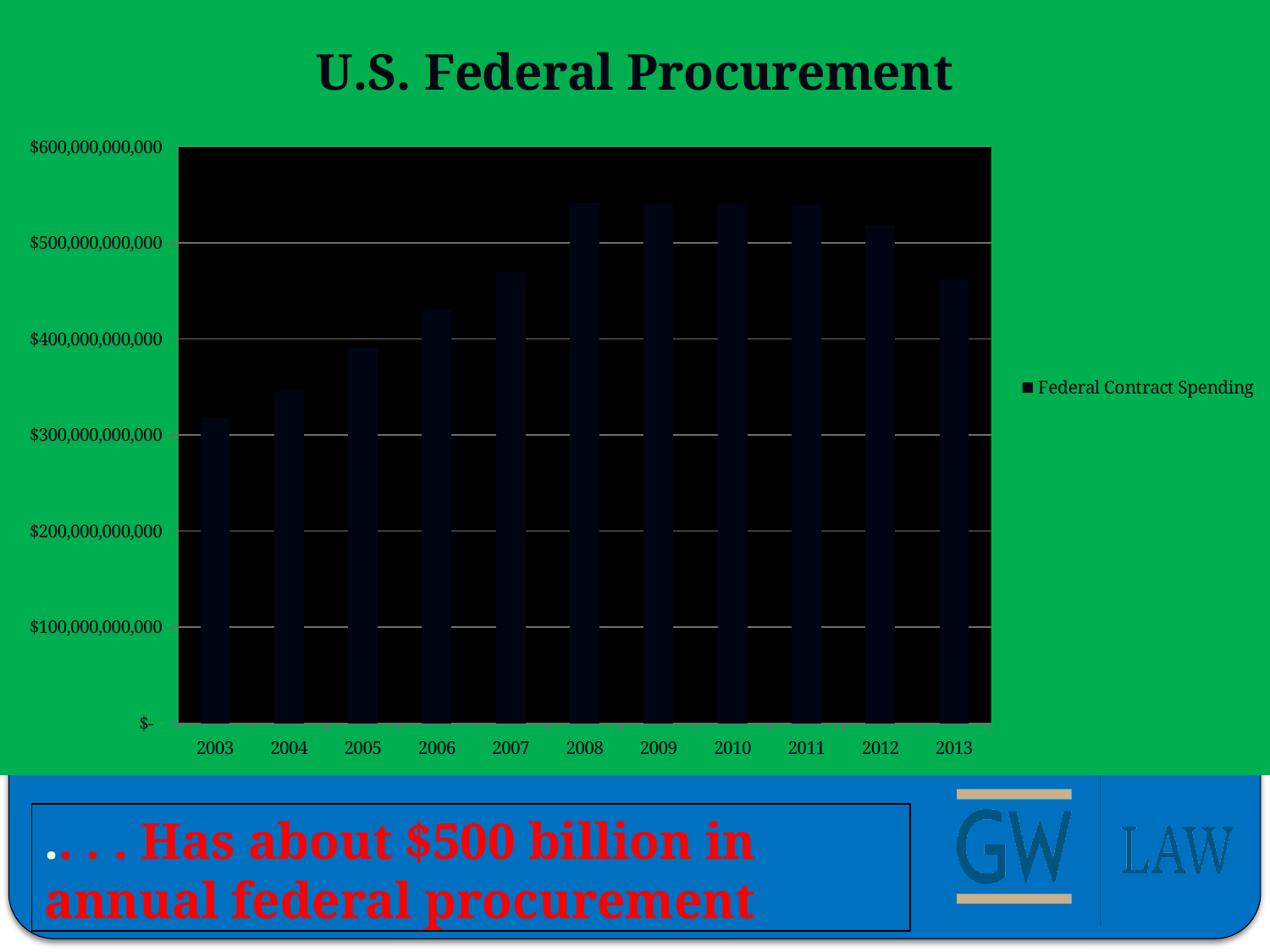
Is the value for 2008 greater or less than $500,000,000,000? greater Which year has the lowest Federal Contract Spending? 2003 How many series does the chart's legend list? 1 What is the name of the series shown in the chart's legend? Federal Contract Spending Does Federal Contract Spending rise or fall from 2003 to 2008? rise Is the value for 2013 greater or less than $500,000,000,000? less Is the value for 2003 greater or less than $300,000,000,000? greater What is the title of the chart? U.S. Federal Procurement How many years are plotted on the x axis of the chart? 11 Which year has the larger Federal Contract Spending, 2003 or 2013? 2013 What kind of chart is shown on the slide? bar chart